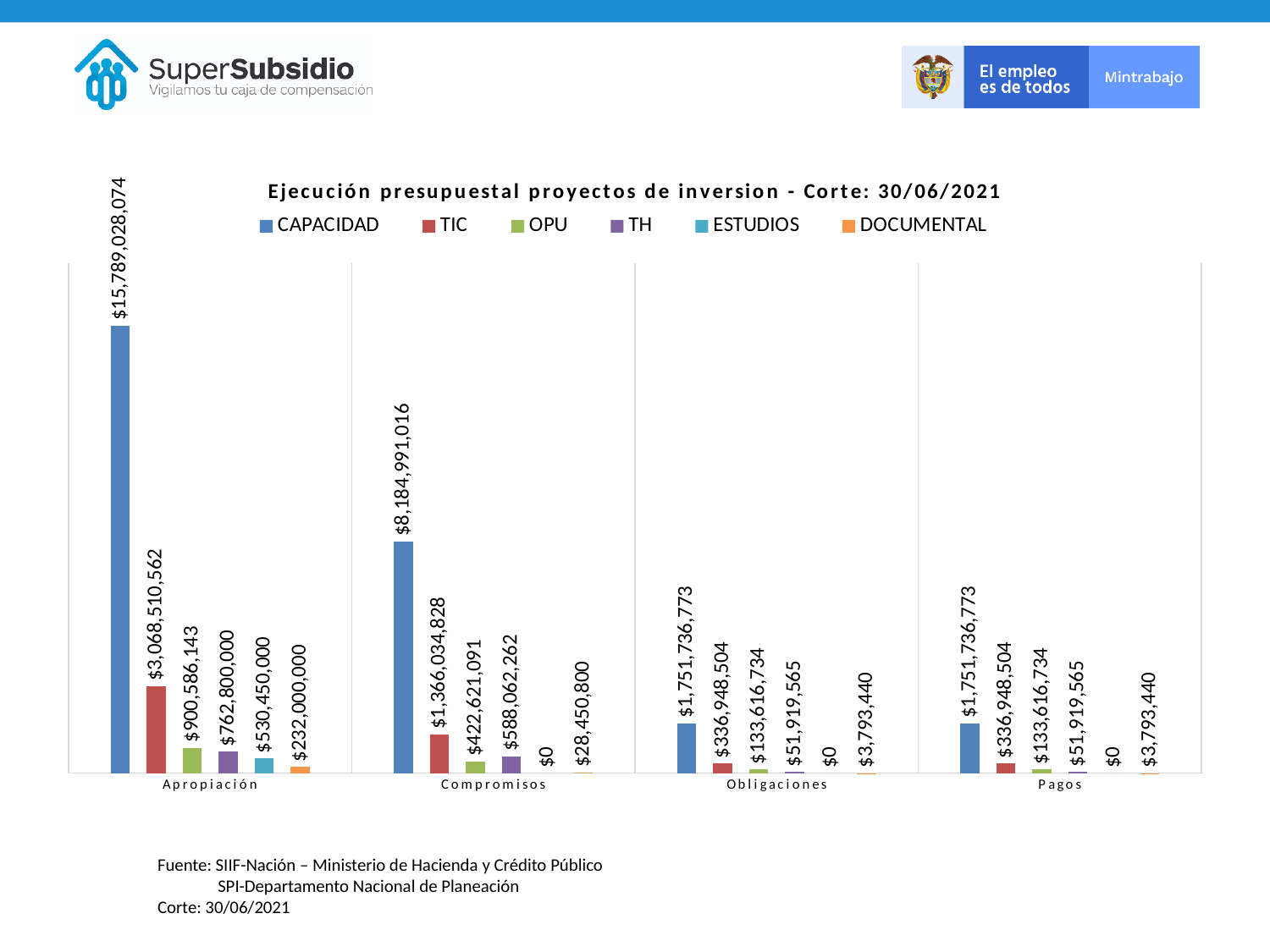
What is the difference between the CAPACIDAD values for Apropiación and Compromisos? $7,604,037,058 How many categories are shown on the x axis? 4 Which series has the lowest value in the Compromisos category? ESTUDIOS What is the value for ESTUDIOS in the Obligaciones category? $0 What is the value for DOCUMENTAL in the Pagos category? $3,793,440 Which is larger in the Compromisos category: OPU or TH? TH What is the title of the chart? Ejecución presupuestal proyectos de inversion - Corte: 30/06/2021 What is the value for TIC in the Compromisos category? $1,366,034,828 What is the value for CAPACIDAD in the Apropiación category? $15,789,028,074 How many series does the legend list? 6 Which series has the highest value in the Apropiación category? CAPACIDAD What type of chart is shown on the slide? Bar chart